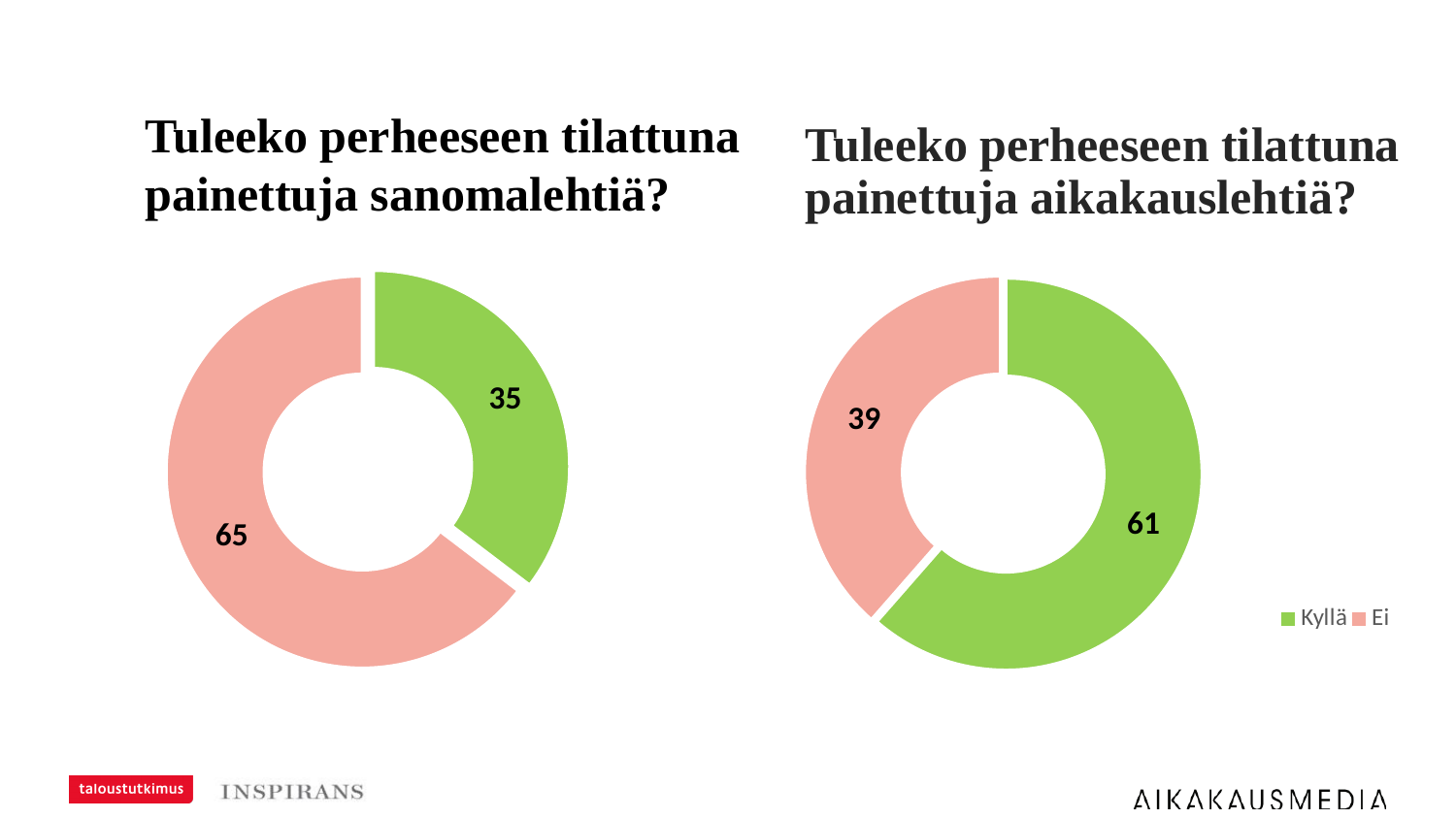
In the left chart ("Tuleeko perheeseen tilattuna painettuja sanomalehtiä?"), what is the value for Ei? 65 In the right chart ("Tuleeko perheeseen tilattuna painettuja aikakauslehtiä?"), which category has the smaller share? Ei In the right chart ("Tuleeko perheeseen tilattuna painettuja aikakauslehtiä?"), what is the value for Ei? 39 In the right chart ("Tuleeko perheeseen tilattuna painettuja aikakauslehtiä?"), what is the value for Kyllä? 61 In the left chart ("Tuleeko perheeseen tilattuna painettuja sanomalehtiä?"), what is the difference between the Ei and Kyllä values? 30 In the left chart ("Tuleeko perheeseen tilattuna painettuja sanomalehtiä?"), which category has the larger share? Ei In the right chart ("Tuleeko perheeseen tilattuna painettuja aikakauslehtiä?"), what is the difference between the Kyllä and Ei values? 22 In the left chart ("Tuleeko perheeseen tilattuna painettuja sanomalehtiä?"), what is the value for Kyllä? 35 Which colour represents Kyllä in the charts? Green What type of chart is used on this slide? Doughnut (pie) chart How many categories does the legend list? 2 Is the Kyllä value larger in the left chart (sanomalehtiä) or in the right chart (aikakauslehtiä)? Right chart (aikakauslehtiä)